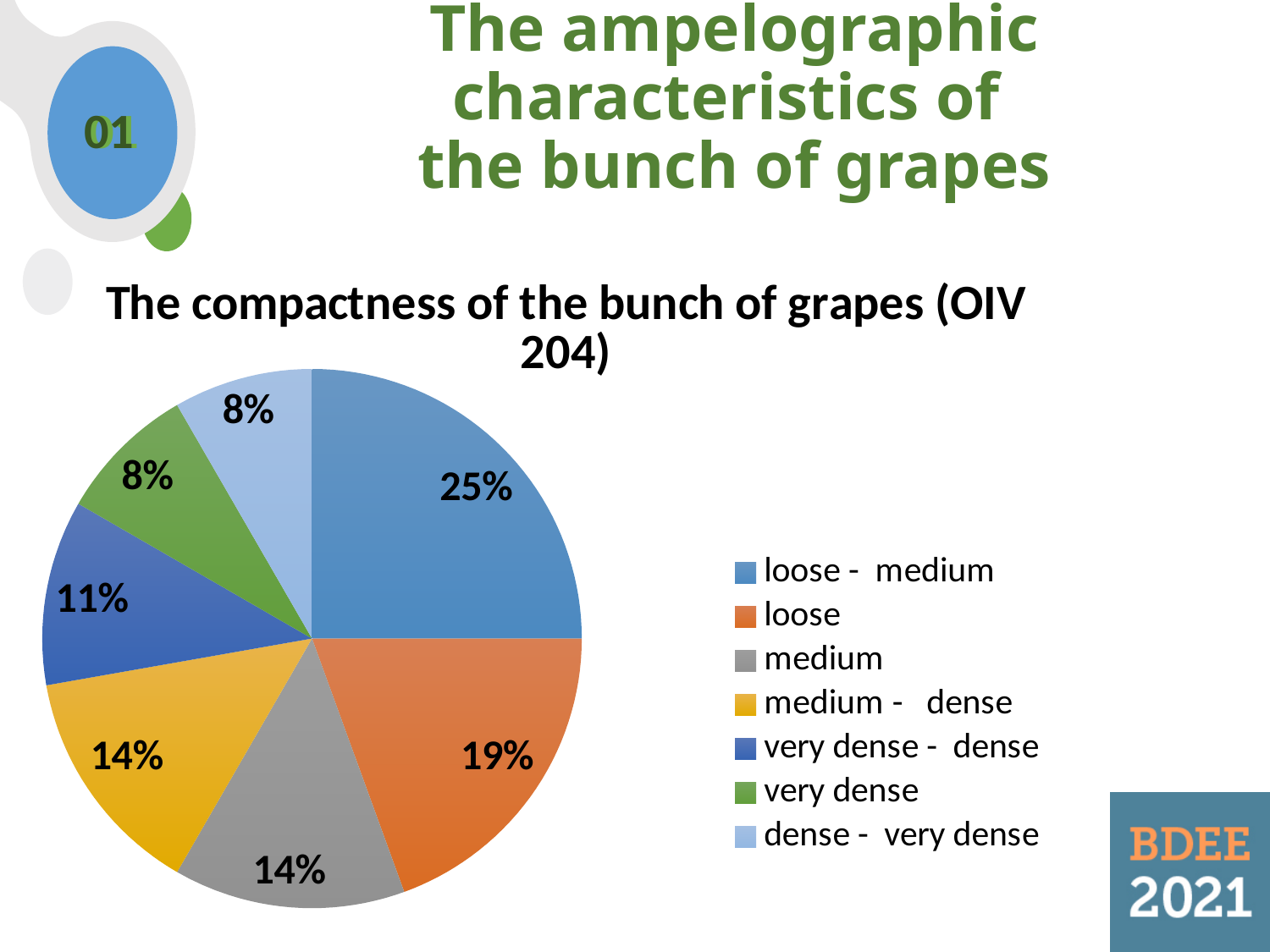
Which has a larger share, 'loose' or 'medium'? loose Which category has the largest share of the pie? loose - medium What share of the pie does the 'loose - medium' category have? 25% What share of the pie does the 'medium - dense' category have? 14% Which category is shown in green in the legend? very dense What share of the pie does the 'very dense - dense' category have? 11% What is the difference in percentage points between the 'loose - medium' and 'loose' shares? 6 What type of chart is shown on the slide? pie chart How many categories does the pie chart have? 7 What is the title of the chart? The compactness of the bunch of grapes (OIV 204)